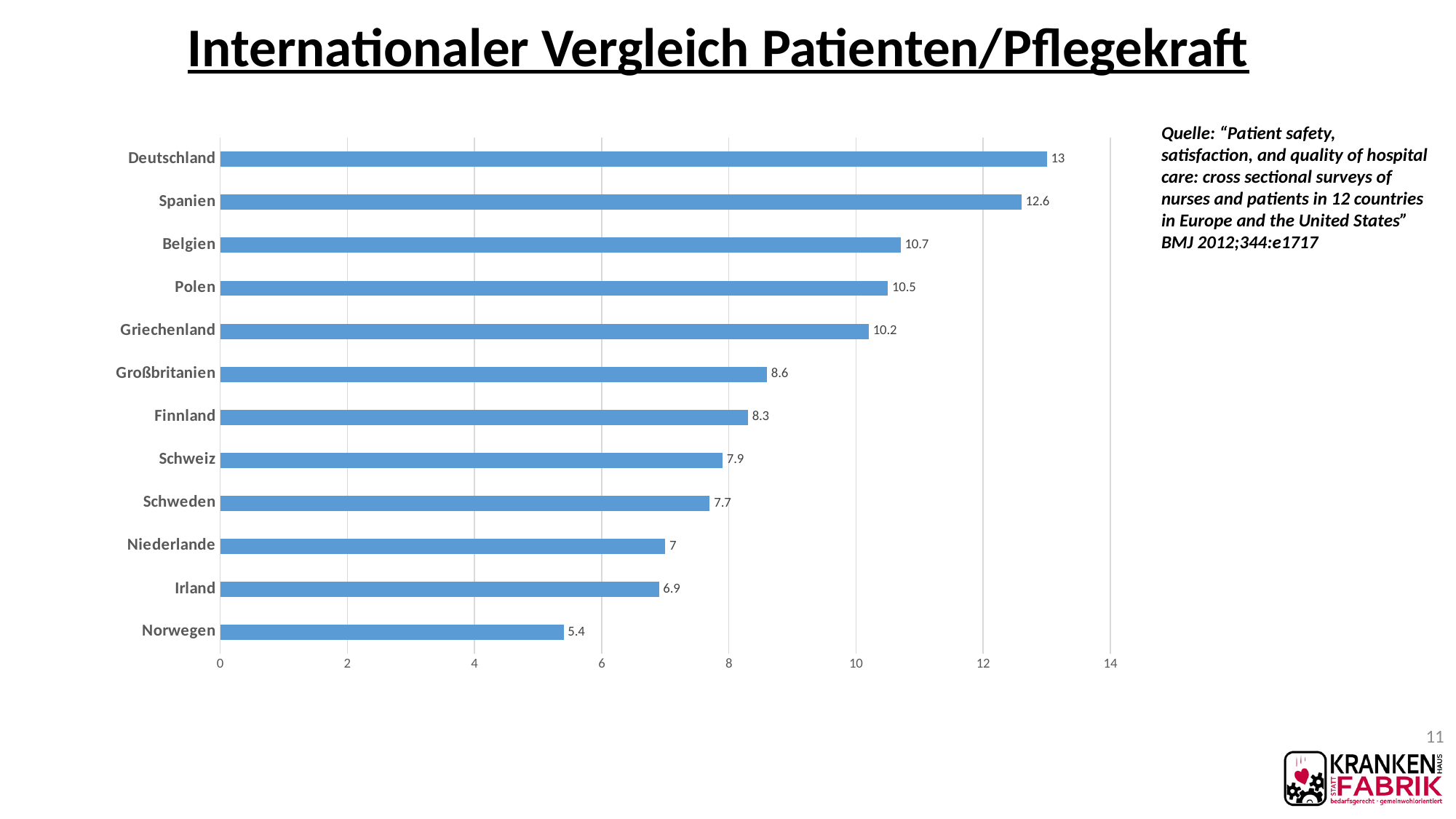
Which has a larger value, Polen or Finnland? Polen Which country has the highest value? Deutschland What is the value for Deutschland? 13 Is the value for Großbritanien greater or less than 8? greater What is the value for Schweden? 7.7 What is the difference between the values for Spanien and Belgien? 1.9 Which country has the lowest value? Norwegen What is the title of the slide? Internationaler Vergleich Patienten/Pflegekraft How many countries are shown in the chart? 12 What kind of chart is shown on the slide? bar chart What is the value for Griechenland? 10.2 What is the difference between the values for Deutschland and Norwegen? 7.6